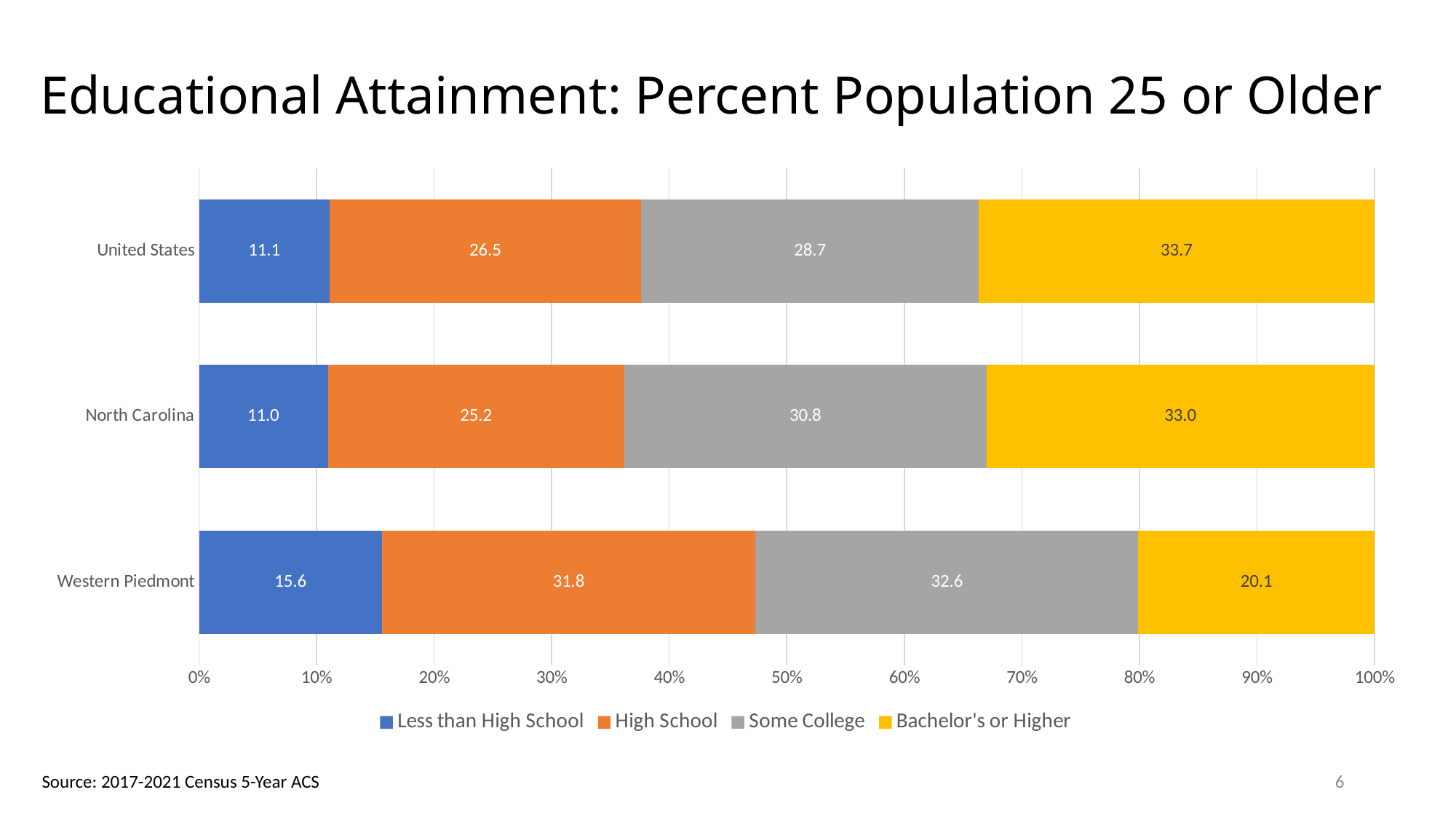
What is the total of the stacked bar for Western Piedmont? 100.1 What kind of chart is shown on the slide? Stacked bar chart What is the Bachelor's or Higher value for Western Piedmont? 20.1 Which colour represents the Some College series? Gray What is the Some College value for North Carolina? 30.8 How many series does the legend list? 4 What is the Less than High School value for the United States? 11.1 Which region has the lowest Bachelor's or Higher value? Western Piedmont Which region has the highest Less than High School value? Western Piedmont Which is larger, the Some College value for the United States or for North Carolina? North Carolina What is the difference between the High School values for Western Piedmont and North Carolina? 6.6 How many regions are shown on the chart? 3